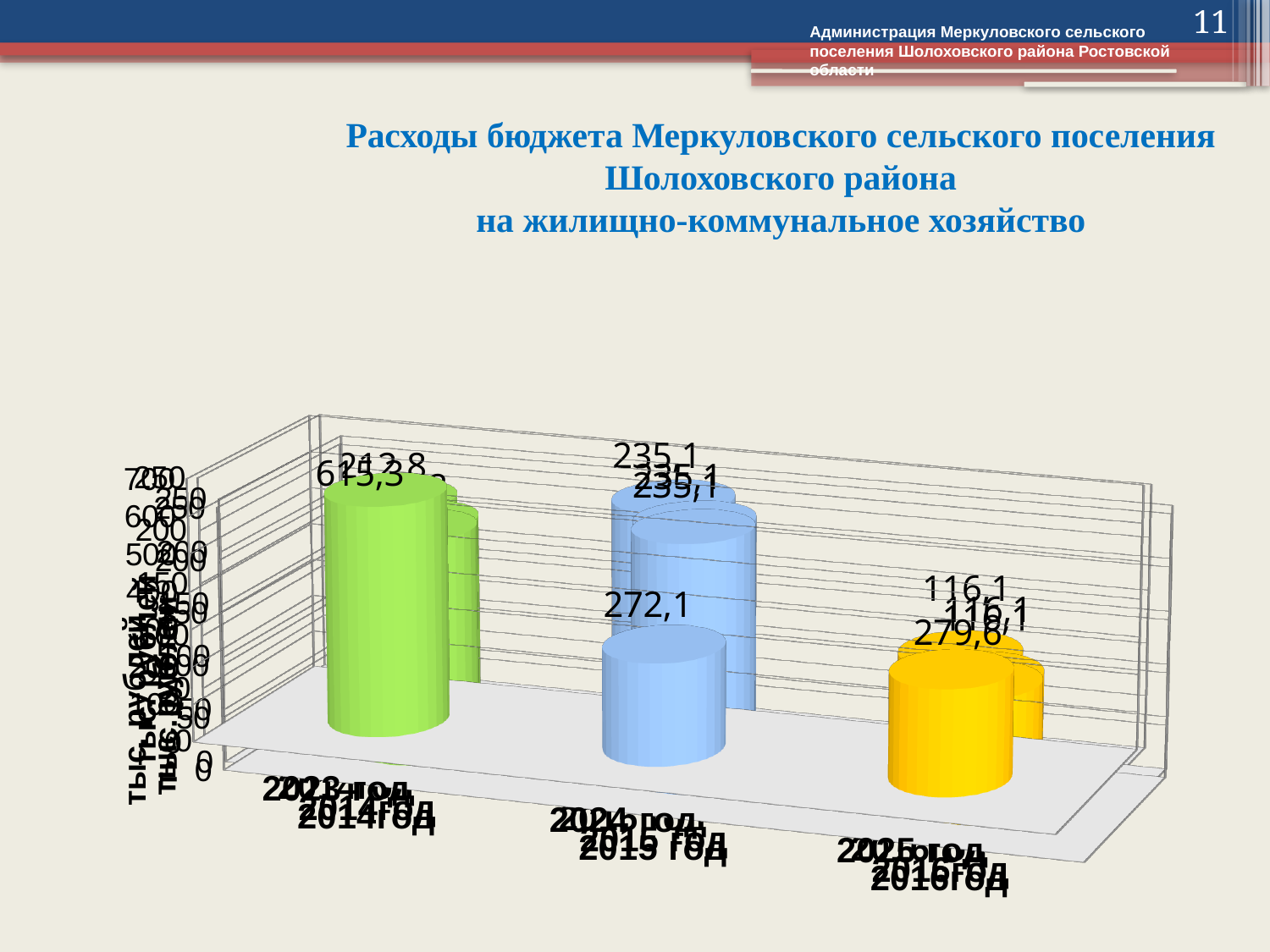
What is the title of the chart on the slide? Расходы бюджета Меркуловского сельского поселения Шолоховского района на жилищно-коммунальное хозяйство Which colour of front bar is the tallest in the chart? green Is the value of the front green bar larger or smaller than the value of the front blue bar? larger What unit is given on the vertical axis of the chart? тыс. рублей What kind of chart is shown on the slide? bar chart How many large front bars are plotted in the chart? 3 What value is labelled on the front blue bar in the middle of the chart? 272,1 What value is labelled on the front yellow bar on the right of the chart? 279,6 What value is labelled on the tall green bar at the front of the chart? 615,3